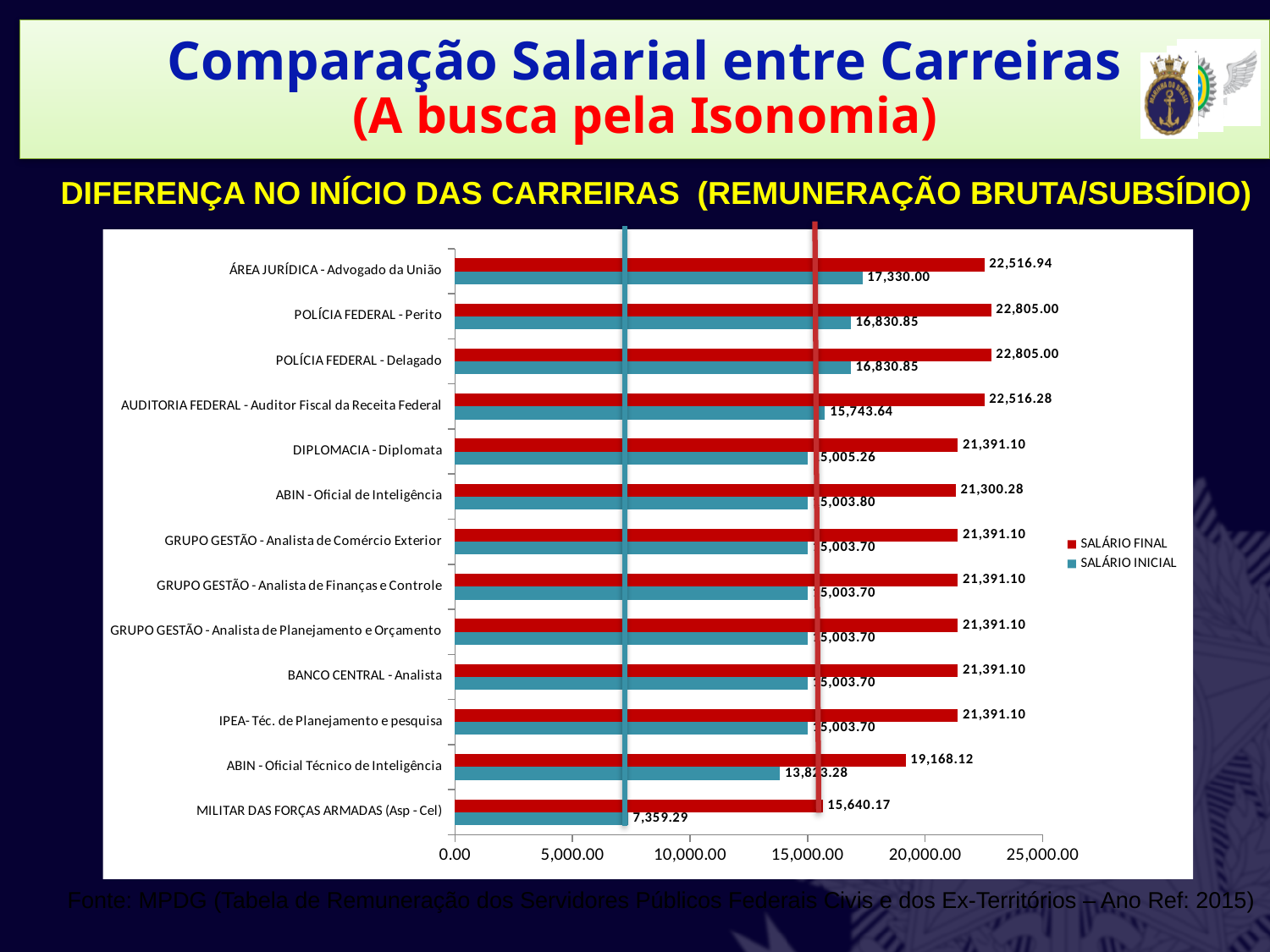
How many series does the legend list? 2 Which category has the highest SALÁRIO INICIAL value? ÁREA JURÍDICA - Advogado da União Which has a larger SALÁRIO INICIAL: ÁREA JURÍDICA - Advogado da União or POLÍCIA FEDERAL - Perito? ÁREA JURÍDICA - Advogado da União What is the SALÁRIO FINAL value for ABIN - Oficial Técnico de Inteligência? 19,168.12 What is the SALÁRIO FINAL value for ÁREA JURÍDICA - Advogado da União? 22,516.94 What is the SALÁRIO INICIAL value for POLÍCIA FEDERAL - Perito? 16,830.85 How many career categories are shown in the chart? 13 What is the difference between SALÁRIO FINAL and SALÁRIO INICIAL for MILITAR DAS FORÇAS ARMADAS (Asp - Cel)? 8,280.88 What is the SALÁRIO INICIAL value for MILITAR DAS FORÇAS ARMADAS (Asp - Cel)? 7,359.29 Which category has the lowest SALÁRIO FINAL value? MILITAR DAS FORÇAS ARMADAS (Asp - Cel) What is the difference between SALÁRIO FINAL and SALÁRIO INICIAL for ÁREA JURÍDICA - Advogado da União? 5,186.94 Is the SALÁRIO INICIAL value for MILITAR DAS FORÇAS ARMADAS (Asp - Cel) greater or less than 10,000.00? less